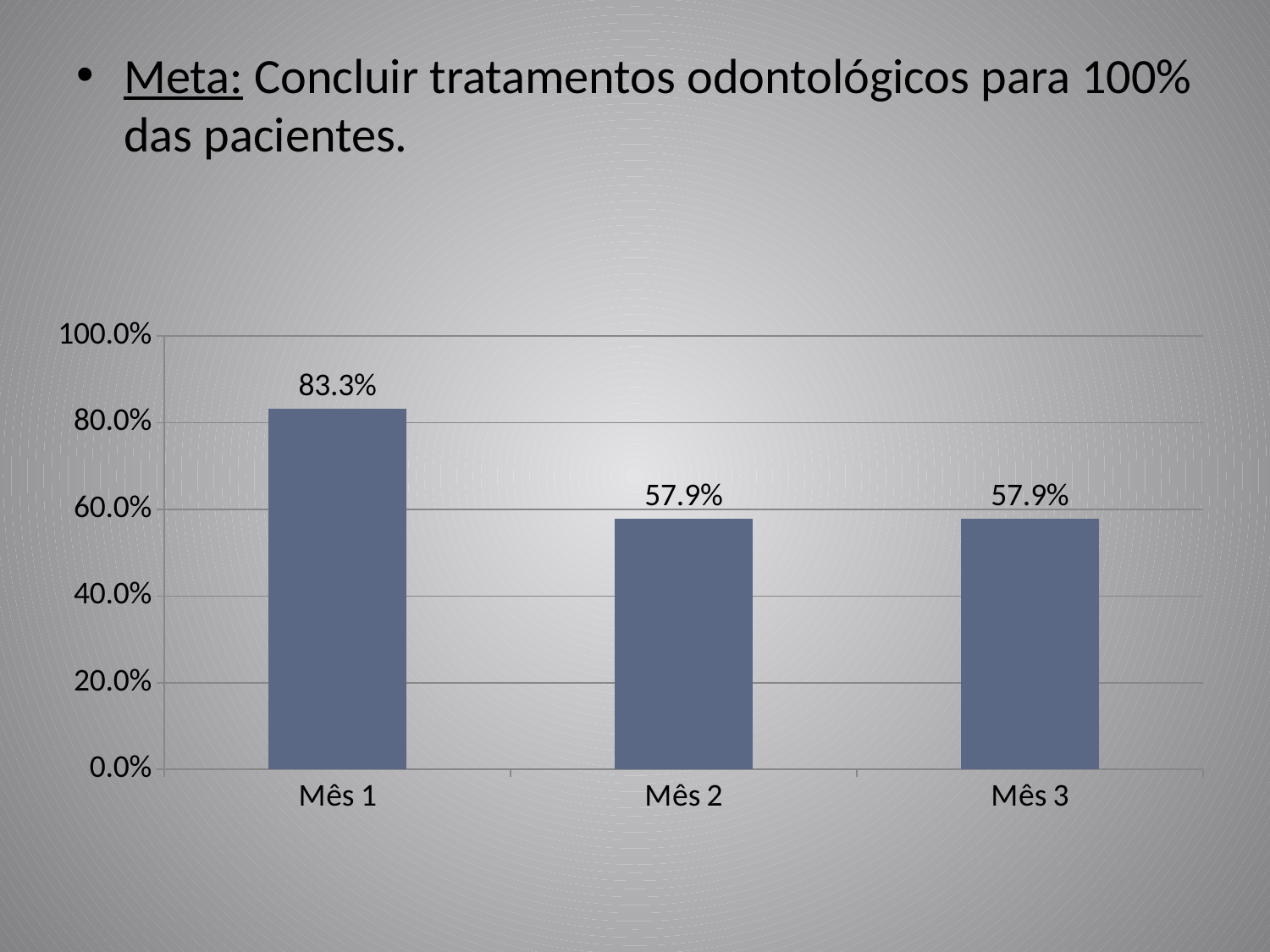
What is the value for Mês 3? 57.9% How many categories are shown on the x axis? 3 Is the value for Mês 2 greater or less than 60.0%? less What kind of chart is shown on the slide? bar chart Is the value for Mês 1 greater or less than 80.0%? greater What is the value for Mês 2? 57.9% What is the highest value shown on the y axis? 100.0% Which is larger, the value for Mês 1 or the value for Mês 3? Mês 1 What is the difference between the values for Mês 1 and Mês 2? 25.4% Which month has the highest value? Mês 1 Do the values rise or fall from Mês 1 to Mês 2? fall What is the value for Mês 1? 83.3%